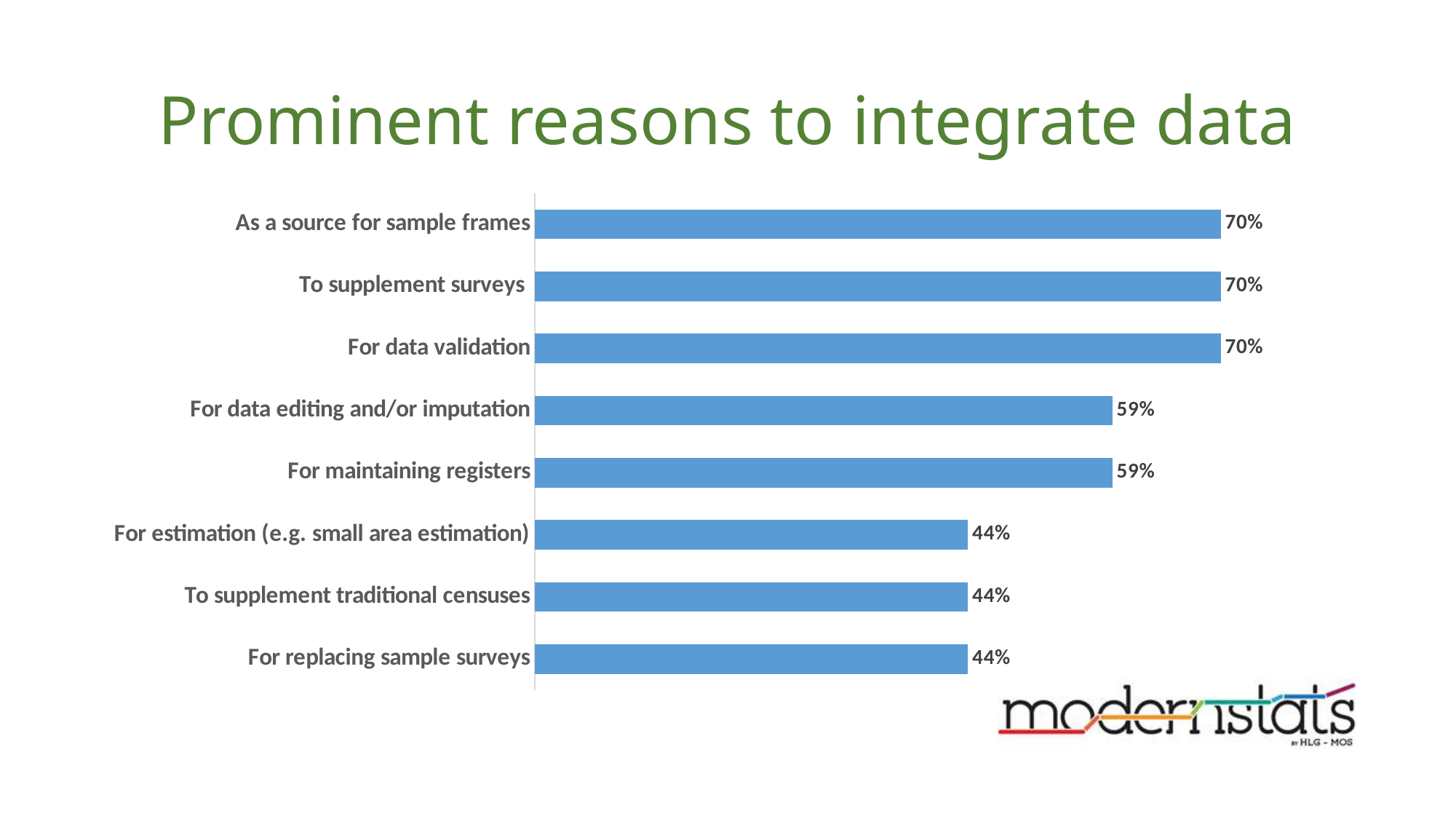
What is the difference between the values for "For data validation" and "For maintaining registers"? 11% What is the difference between the values for "To supplement surveys" and "For estimation (e.g. small area estimation)"? 26% What is the highest value shown in the chart? 70% What is the value for "As a source for sample frames"? 70% What is the value for "For replacing sample surveys"? 44% What is the value for "For maintaining registers"? 59% What is the title of the slide? Prominent reasons to integrate data Which is larger, the value for "For data editing and/or imputation" or the value for "To supplement traditional censuses"? For data editing and/or imputation What kind of chart is shown on the slide? Bar chart How many categories are shown in the chart? 8 What is the lowest value shown in the chart? 44% What is the value for "For data editing and/or imputation"? 59%